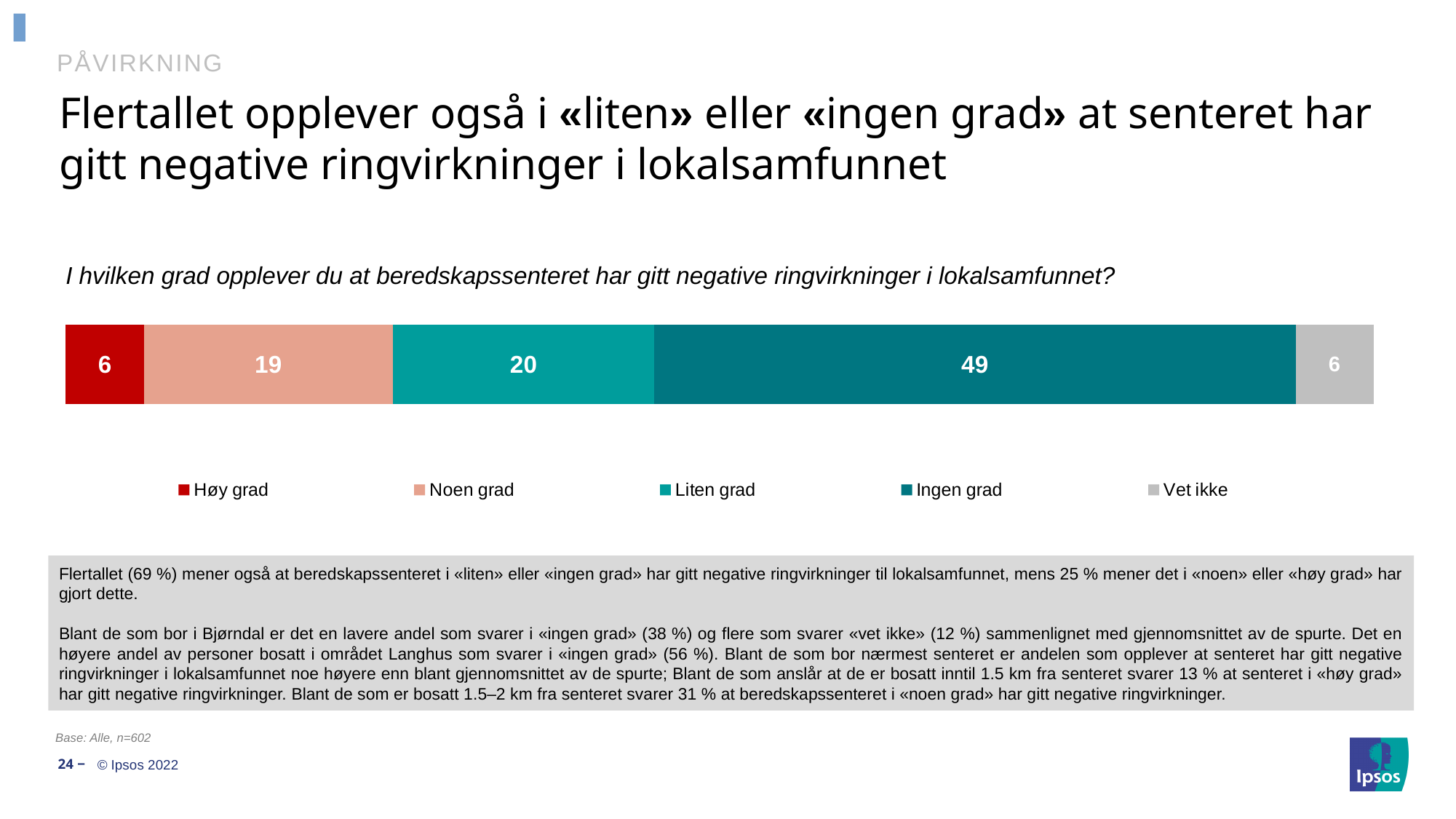
What kind of chart is shown on the slide? Stacked bar chart What value is shown for "Noen grad" in the stacked bar? 19 What is the combined value of the "Liten grad" and "Ingen grad" segments? 69 What value is shown for "Liten grad" in the stacked bar? 20 What value is shown for "Ingen grad" in the stacked bar? 49 Which legend entry is shown in grey? Vet ikke Which is larger, the value for "Noen grad" or the value for "Liten grad"? Liten grad Which legend category has the largest segment in the bar? Ingen grad What is the difference between the values for "Ingen grad" and "Liten grad"? 29 What value is shown for "Høy grad" in the stacked bar? 6 What is the total of all segments in the stacked bar? 100 How many series does the legend list? 5